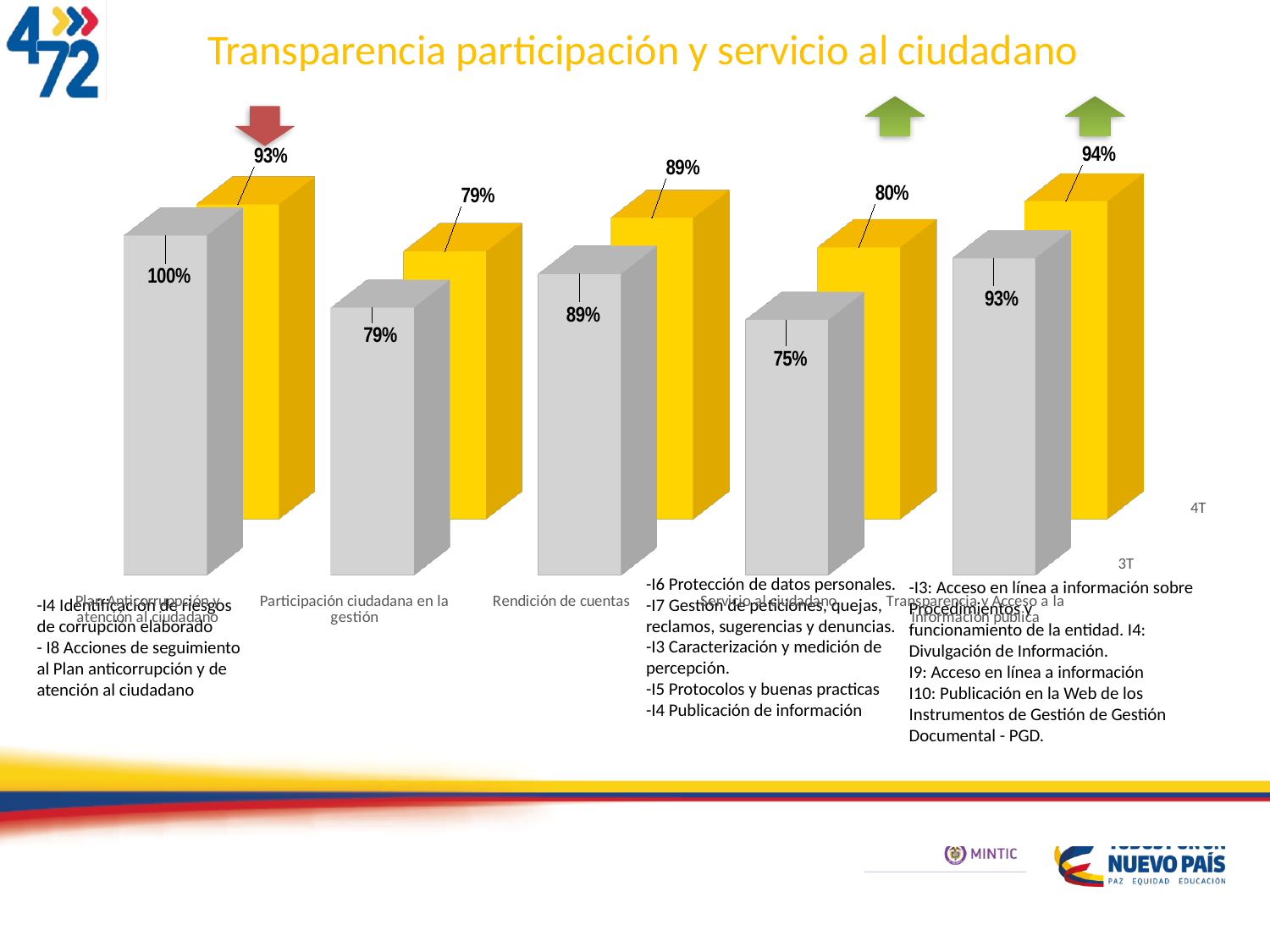
Which category has the lowest 4T value? Participación ciudadana en la gestión What is the 4T value for Rendición de cuentas? 89% How many series does the chart show? 2 What is the 4T value for Transparencia y Acceso a la Información pública? 94% What is the 3T value for Servicio al ciudadano? 75% What is the difference between the 3T and 4T values for Plan Anticorrupción y atención al ciudadano? 7% Which is larger for Servicio al ciudadano, the 3T value or the 4T value? 4T What kind of chart is shown on the slide? bar chart How many categories are shown on the chart? 5 What is the 3T value for Participación ciudadana en la gestión? 79% Which category has the highest 3T value? Plan Anticorrupción y atención al ciudadano Which category has the lowest 3T value? Servicio al ciudadano